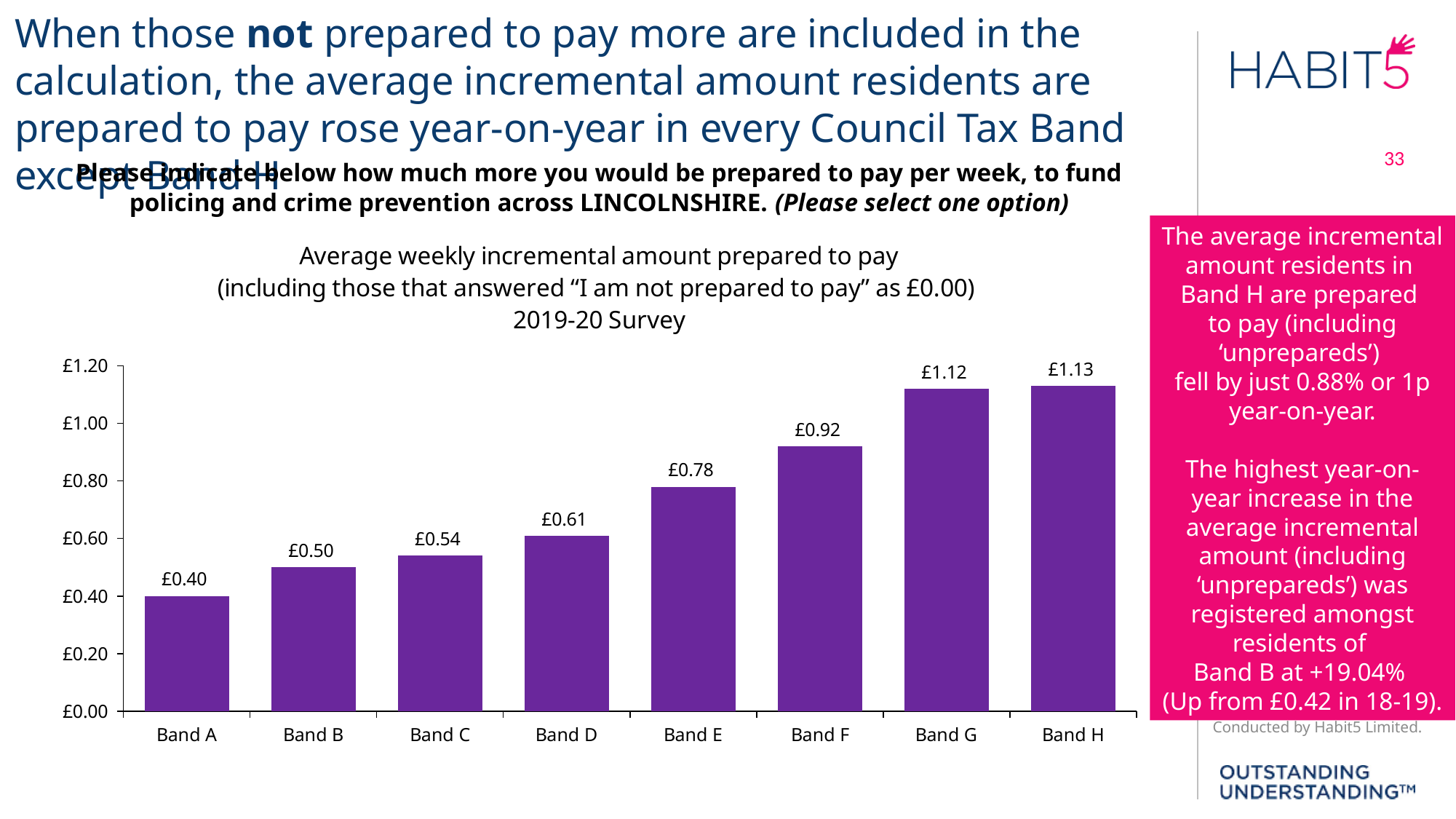
Which Council Tax Band has the lowest average weekly incremental amount? Band A What is the average weekly incremental amount prepared to pay for Band D? £0.61 What is the average weekly incremental amount prepared to pay for Band A? £0.40 What is the difference between the values for Band G and Band B? £0.62 Is the value for Band F greater or less than £1.00? less Which is larger, the value for Band C or the value for Band E? Band E Which survey year does the chart cover? 2019-20 Survey Do the values rise or fall from Band A to Band H? rise What is the average weekly incremental amount prepared to pay for Band F? £0.92 How many Council Tax Bands are shown on the chart? 8 What kind of chart is shown on the slide? bar chart Which Council Tax Band has the highest average weekly incremental amount? Band H